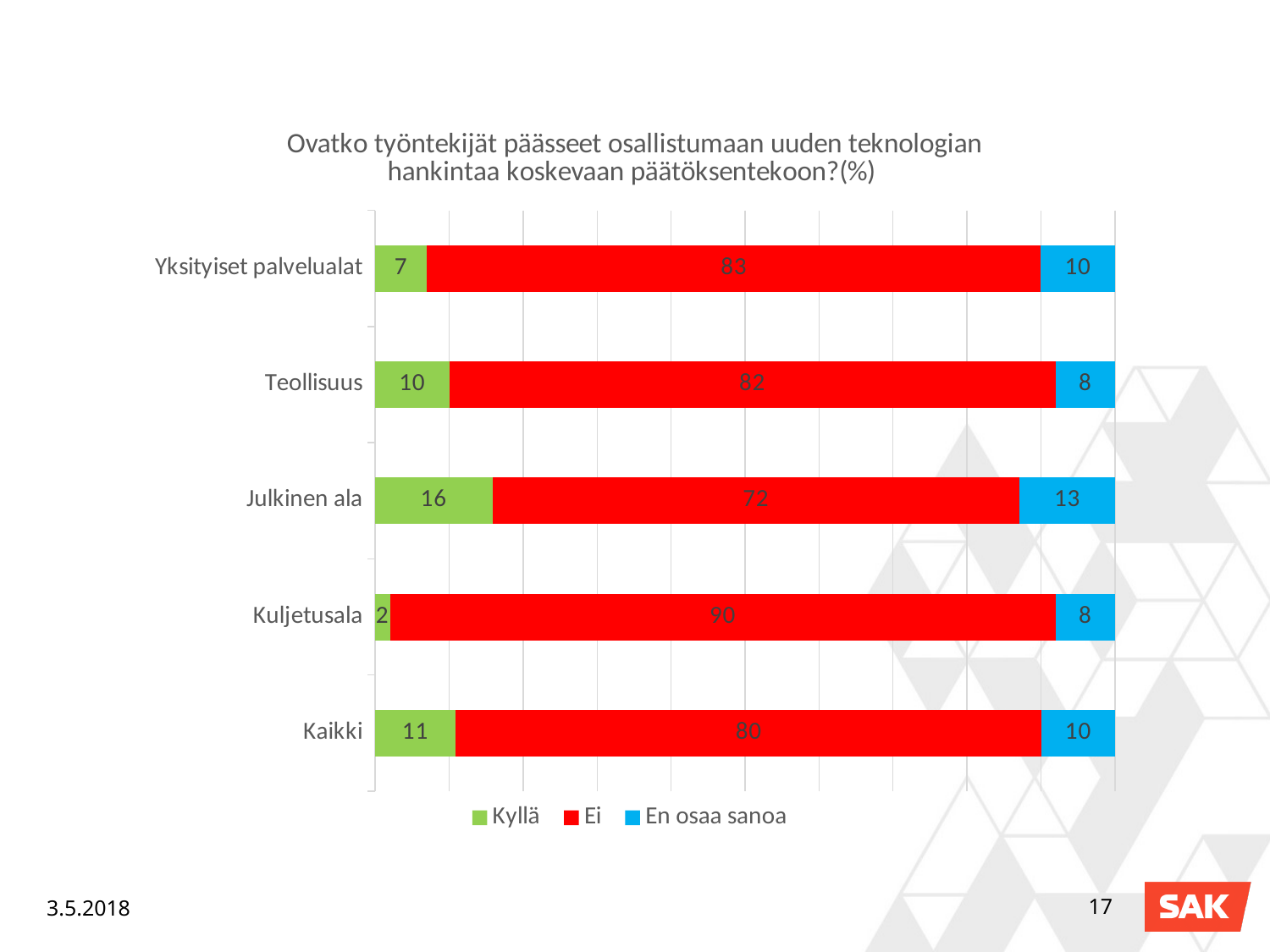
How many categories are shown on the chart? 5 What is the difference between the "Ei" values for Kuljetusala and Julkinen ala? 18 What is the "Kyllä" value for Julkinen ala? 16 What is the "Ei" value for Kuljetusala? 90 Which category has the lowest "Kyllä" value? Kuljetusala Which category has the highest "Ei" value? Kuljetusala Which is larger: the "Kyllä" value for Teollisuus or for Yksityiset palvelualat? Teollisuus What kind of chart is shown on the slide? Stacked bar chart What is the total of the stacked bar for Julkinen ala? 101 What is the "Kyllä" value for Kaikki? 11 What is the "En osaa sanoa" value for Teollisuus? 8 How many series does the legend list? 3